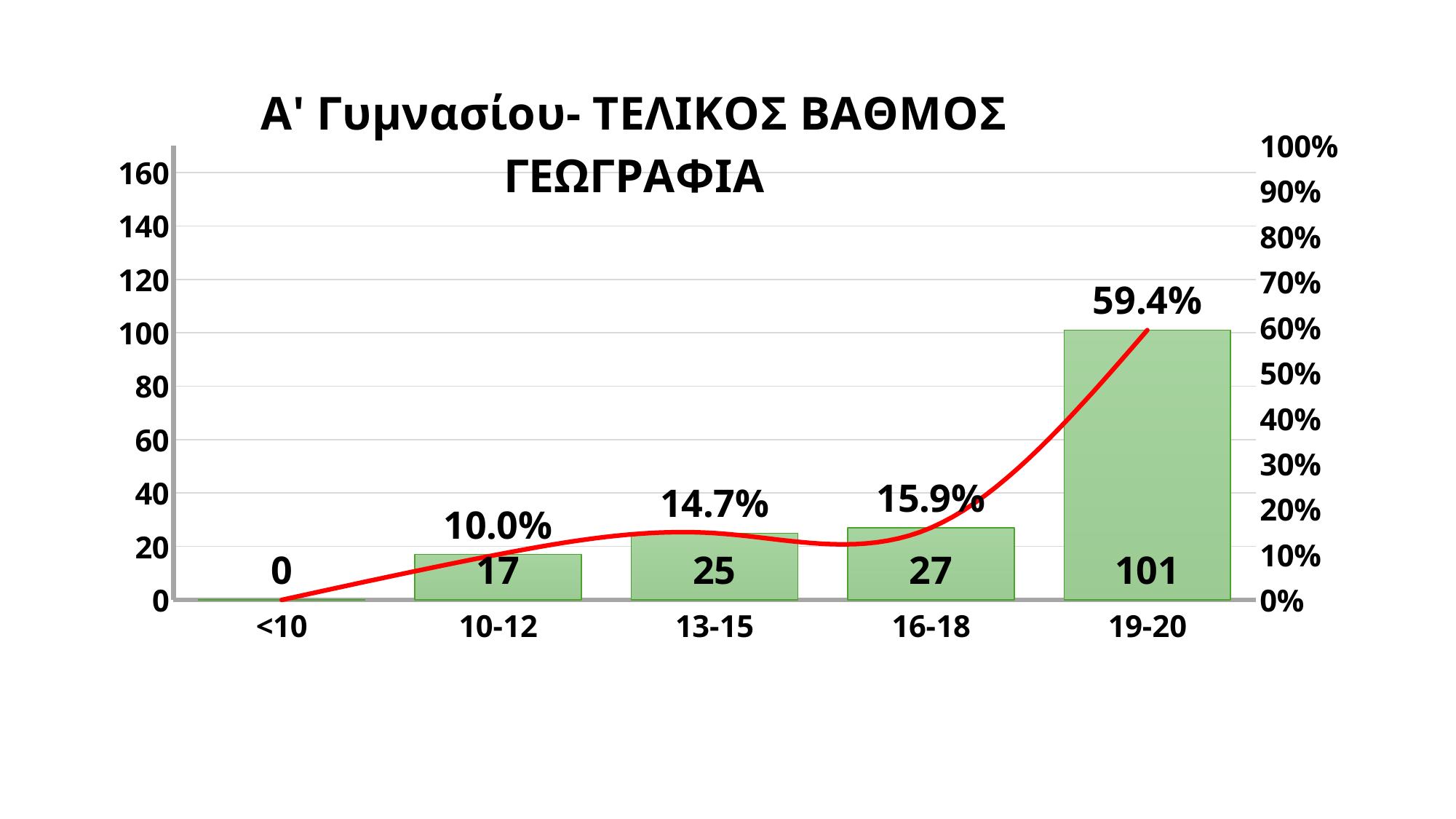
What is the title of the chart? Α' Γυμνασίου- ΤΕΛΙΚΟΣ ΒΑΘΜΟΣ ΓΕΩΓΡΑΦΙΑ Which grade band has the lowest number of students? <10 Which grade band has more students, 10-12 or 13-15? 13-15 Which grade band has the highest number of students? 19-20 What is the number of students in the 19-20 grade band? 101 What is the number of students in the 13-15 grade band? 25 How many grade bands are shown on the x axis? 5 What percentage is shown by the line for the 10-12 grade band? 10.0% Does the percentage line rise or fall from the 16-18 band to the 19-20 band? Rise What is the difference in the number of students between the 19-20 and 16-18 grade bands? 74 What kind of chart is this? Combined bar and line chart What percentage is shown by the line for the 16-18 grade band? 15.9%